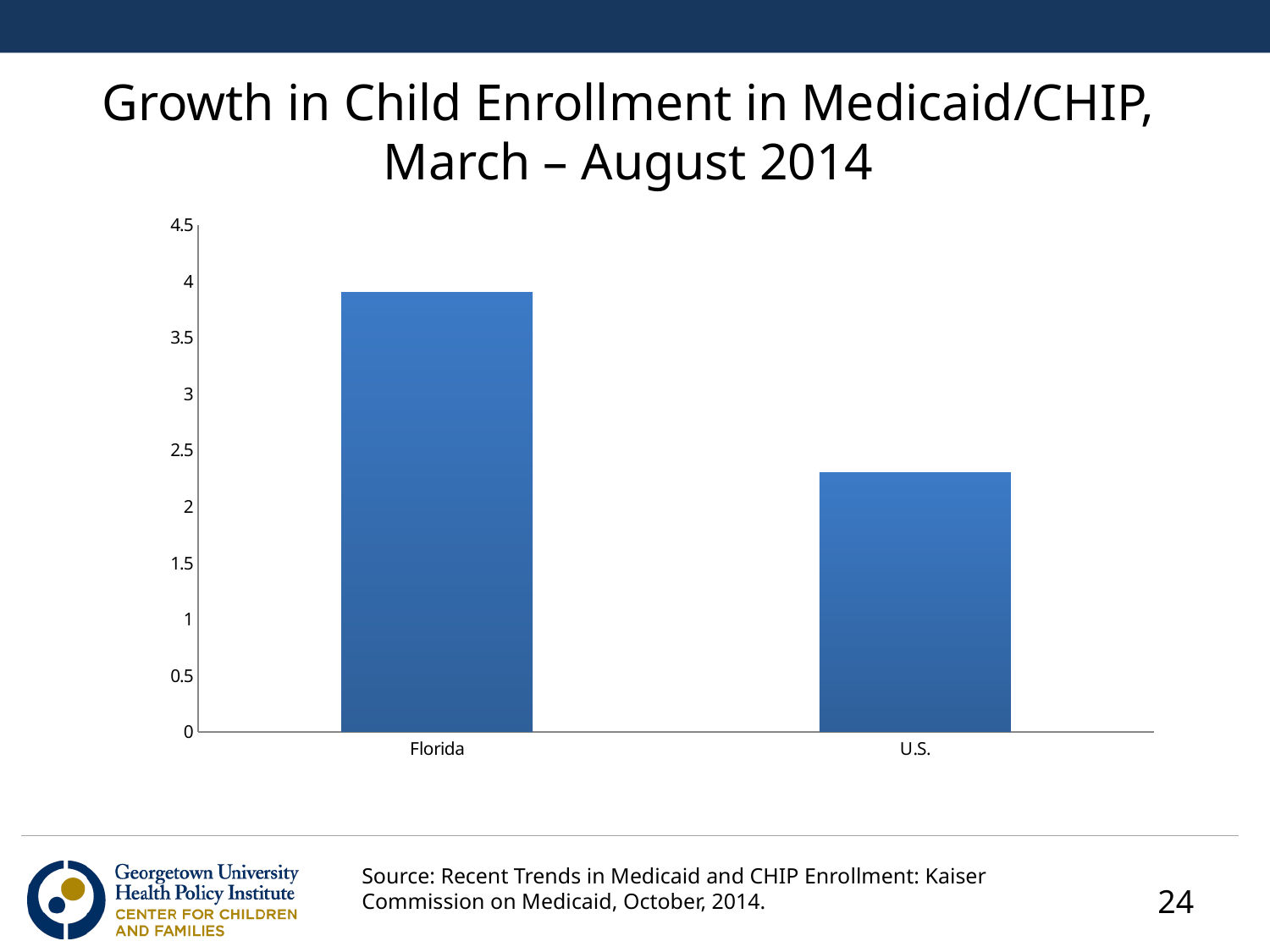
Do the values rise or fall moving from Florida to U.S. along the x axis? fall What kind of chart is shown on the slide? bar chart What is the highest value shown on the y axis? 4.5 Which is larger, the value for Florida or the value for U.S.? Florida Which category has the lowest value on the chart? U.S. How many categories are plotted on the chart? 2 What is the title of the chart? Growth in Child Enrollment in Medicaid/CHIP, March – August 2014 Is the value for Florida greater or less than 3.5? greater Is the value for U.S. greater or less than 2? greater Is the value for U.S. greater or less than 2.5? less Which category has the highest value on the chart? Florida